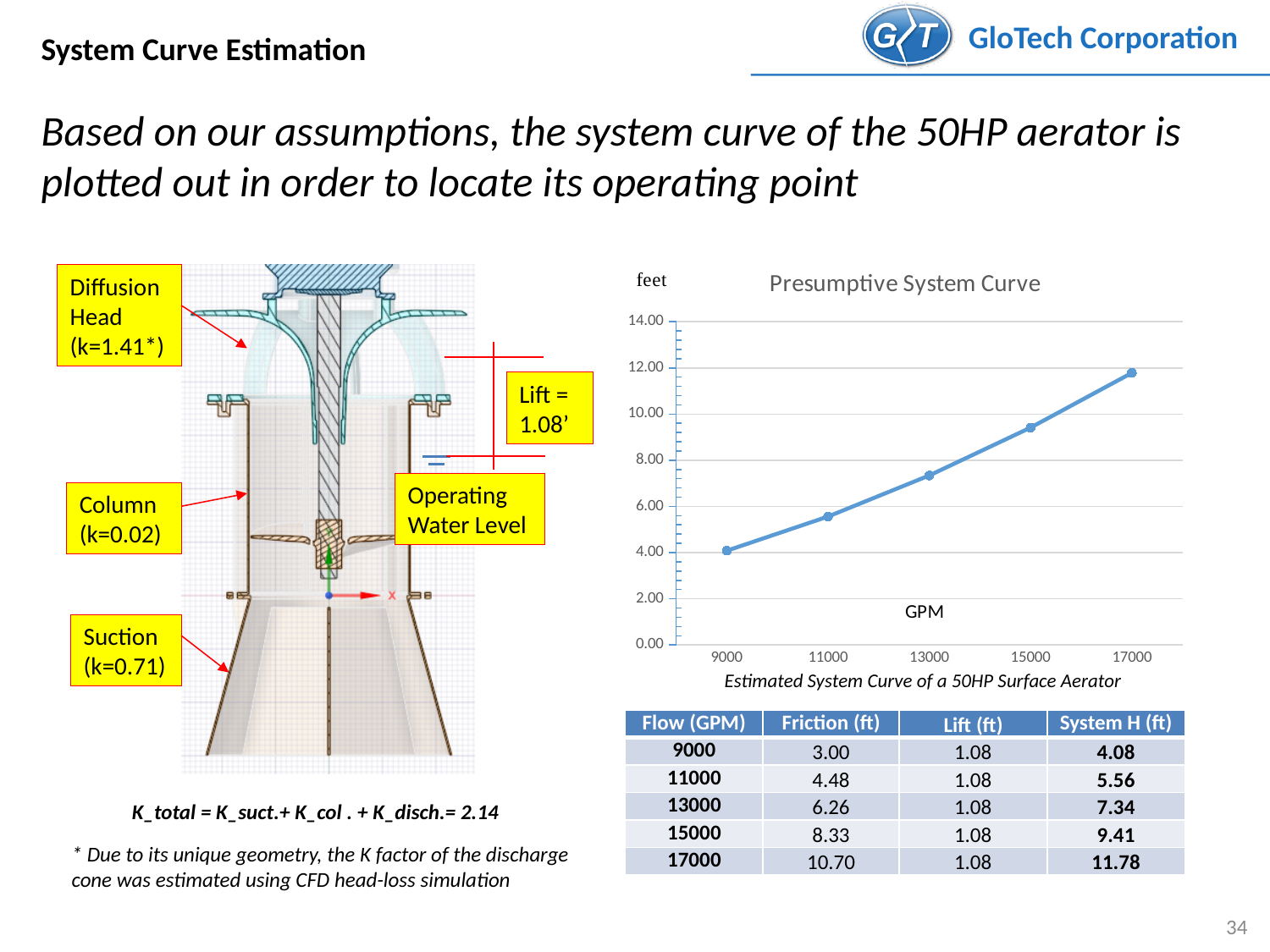
On the Presumptive System Curve, is the value at 17000 GPM greater or less than 10.00? greater How many data points are plotted on the Presumptive System Curve? 5 Do the values on the Presumptive System Curve rise or fall as GPM increases? rise What kind of chart is the Presumptive System Curve? line chart On the Presumptive System Curve, is the value at 11000 GPM greater or less than 6.00? less At which GPM value is the Presumptive System Curve lowest? 9000 What unit is shown on the vertical axis of the Presumptive System Curve chart? feet On the Presumptive System Curve, is the value at 17000 GPM greater or less than 12.00? less Which is larger on the Presumptive System Curve, the value at 13000 GPM or the value at 15000 GPM? 15000 GPM At which GPM value is the Presumptive System Curve highest? 17000